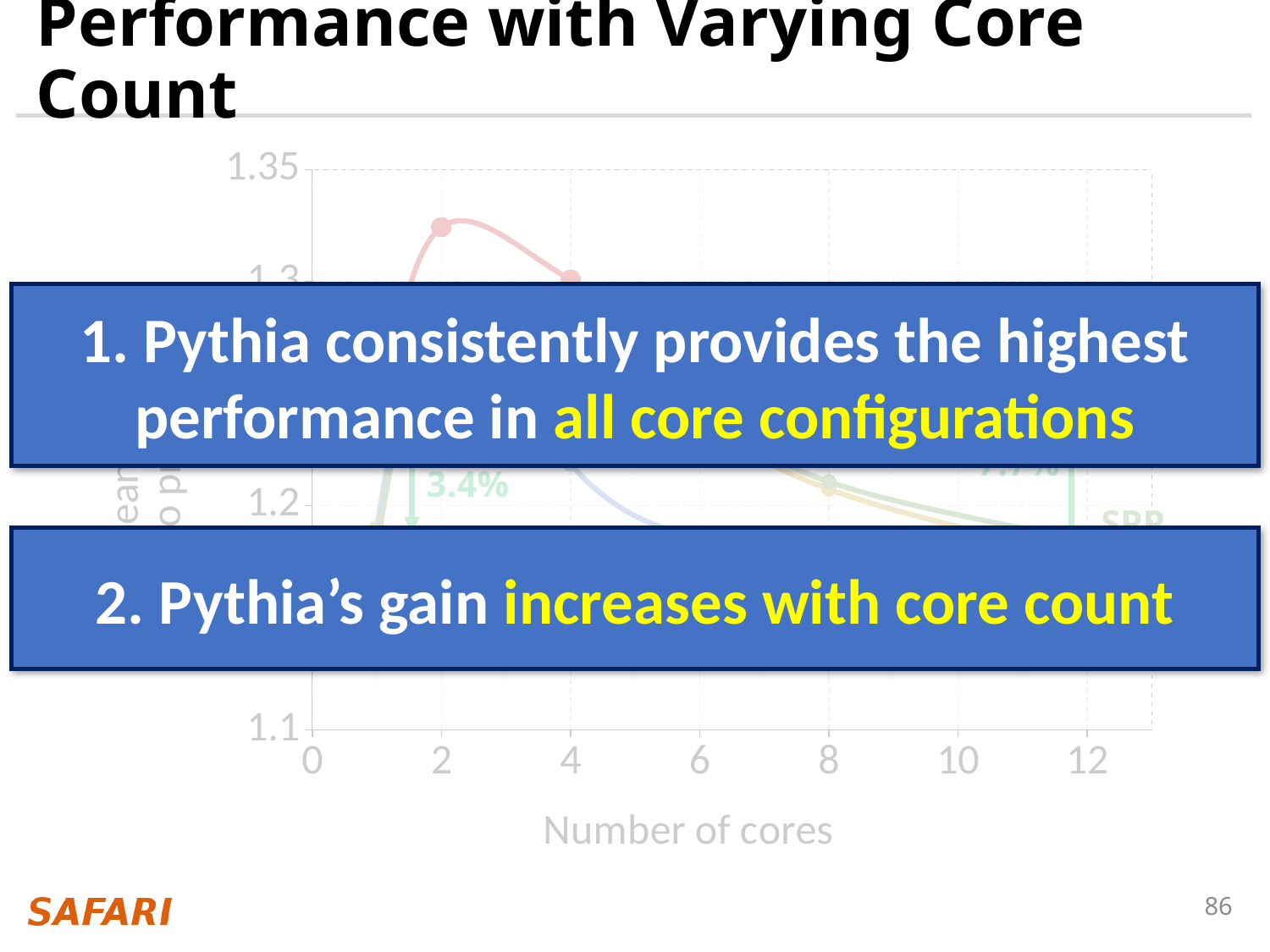
What is the label of the x axis of the chart? Number of cores What kind of chart is shown on the slide? line chart Is the value of the red line at 2 cores greater or less than 1.35? less What is the highest tick value shown on the y axis of the chart? 1.35 Which of the red line's two visible points is higher, the one at 2 cores or the one at 4 cores? 2 cores Does the red line rise or fall between 2 cores and 4 cores? fall Is the value of the red line at 2 cores greater or less than 1.3? greater